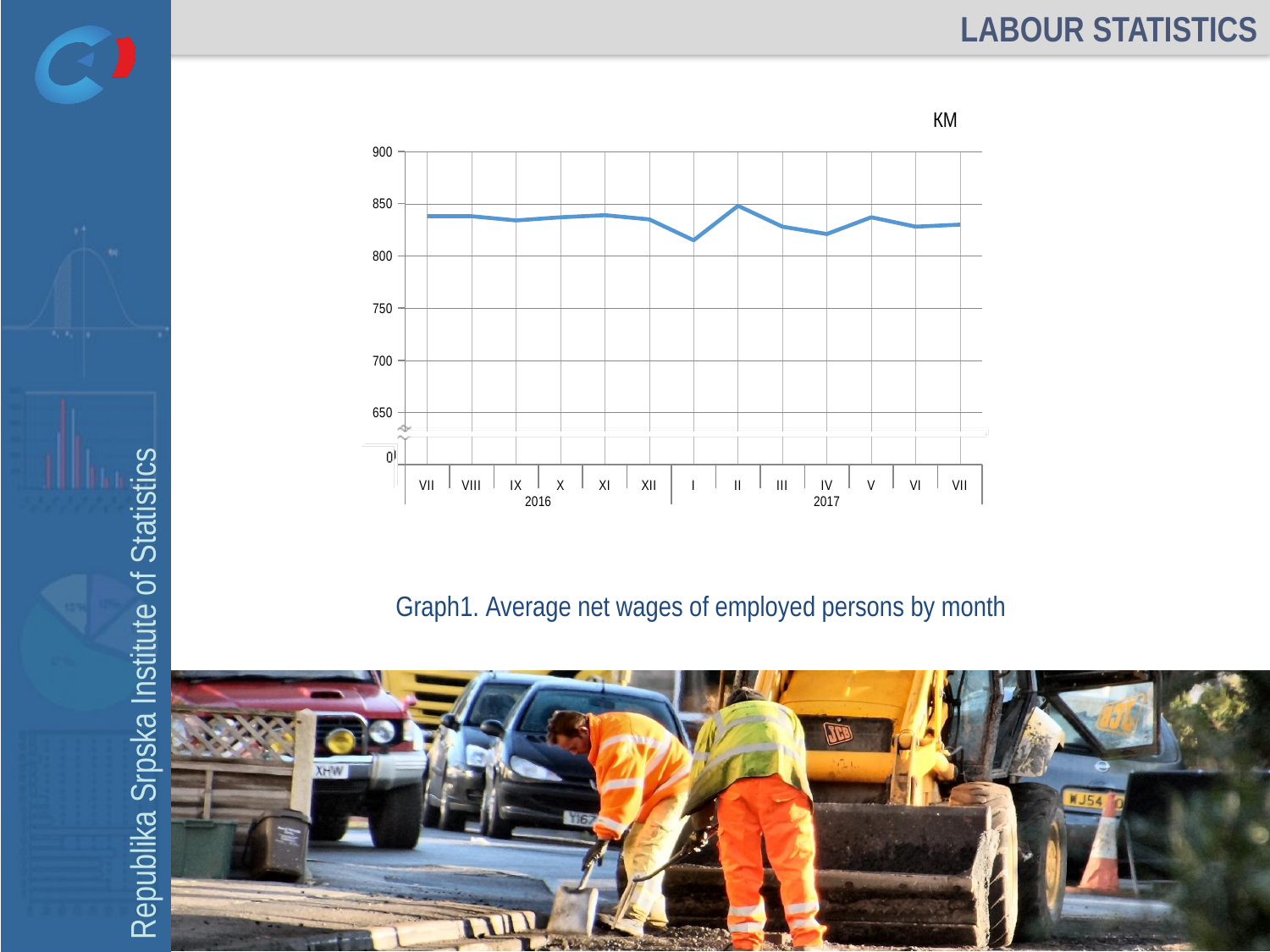
Is the value for I 2017 greater or less than 800? greater What kind of chart is shown on the slide? line chart Which is larger, the value for I 2017 or the value for II 2017? II 2017 Does the line rise or fall from XII 2016 to I 2017? fall How many monthly data points are plotted on the chart? 13 Is the value for XII 2016 greater or less than 800? greater What unit is shown above the chart's vertical axis? KM In which month is the average net wage highest? II 2017 What is the title of the graph? Graph1. Average net wages of employed persons by month In which month is the average net wage lowest? I 2017 Which is larger, the value for XII 2016 or the value for I 2017? XII 2016 Is the value for VII 2016 greater or less than 850? less